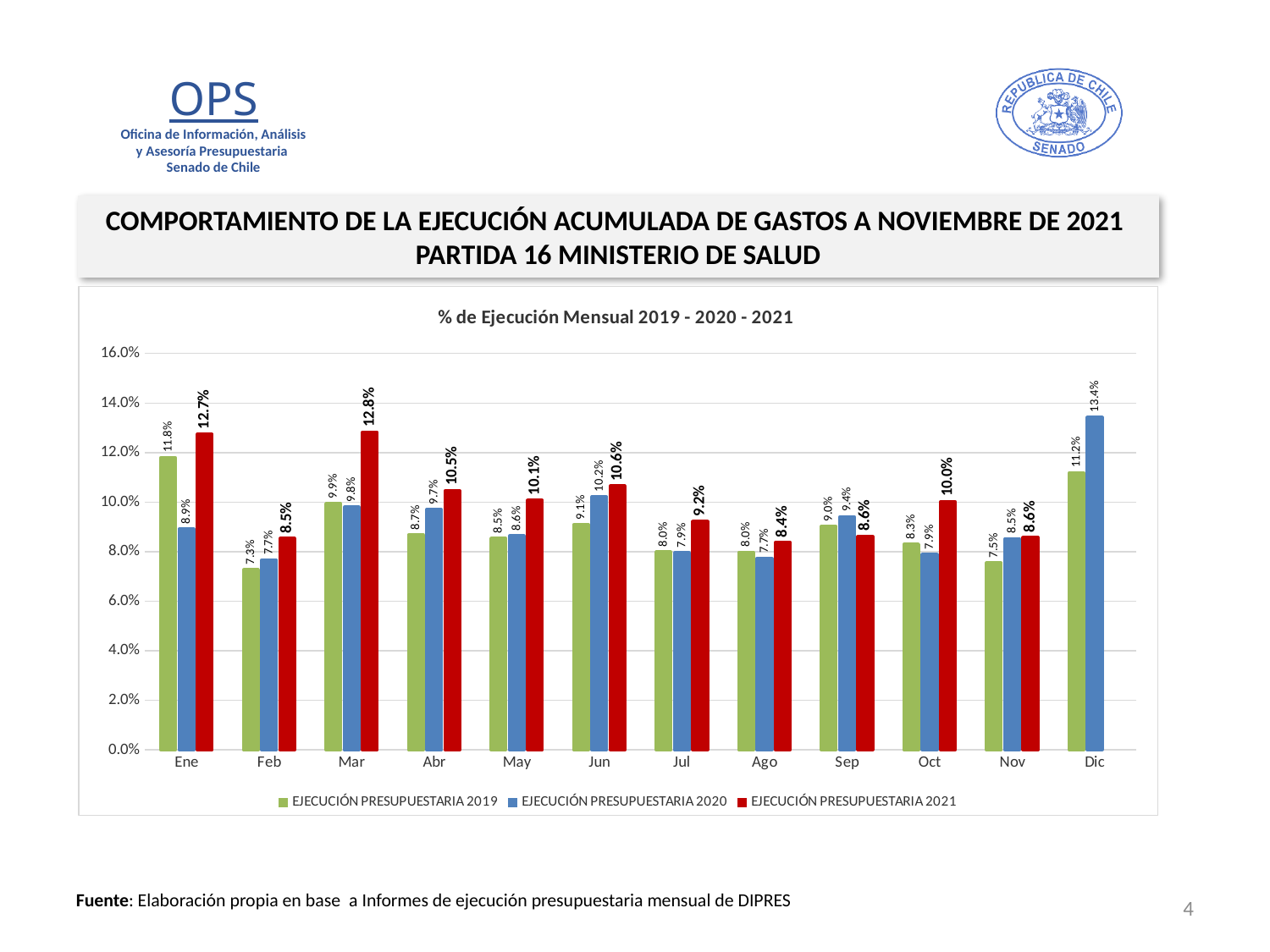
What is the value for EJECUCIÓN PRESUPUESTARIA 2020 in Dic? 13.4% How many series does the legend list? 3 What kind of chart is shown on the slide? Bar chart In which month is the EJECUCIÓN PRESUPUESTARIA 2021 value highest? Mar In which month is the EJECUCIÓN PRESUPUESTARIA 2019 value lowest? Feb Which is larger in Sep: the EJECUCIÓN PRESUPUESTARIA 2020 value or the EJECUCIÓN PRESUPUESTARIA 2021 value? EJECUCIÓN PRESUPUESTARIA 2020 What is the value for EJECUCIÓN PRESUPUESTARIA 2021 in Mar? 12.8% What is the value for EJECUCIÓN PRESUPUESTARIA 2019 in Ene? 11.8% What is the difference between the 2021 and 2019 values in Mar? 2.9 percentage points Is the value for EJECUCIÓN PRESUPUESTARIA 2021 in Ene greater or less than 12.0%? greater What is the title of the chart? % de Ejecución Mensual 2019 - 2020 - 2021 How many months are shown on the x axis? 12